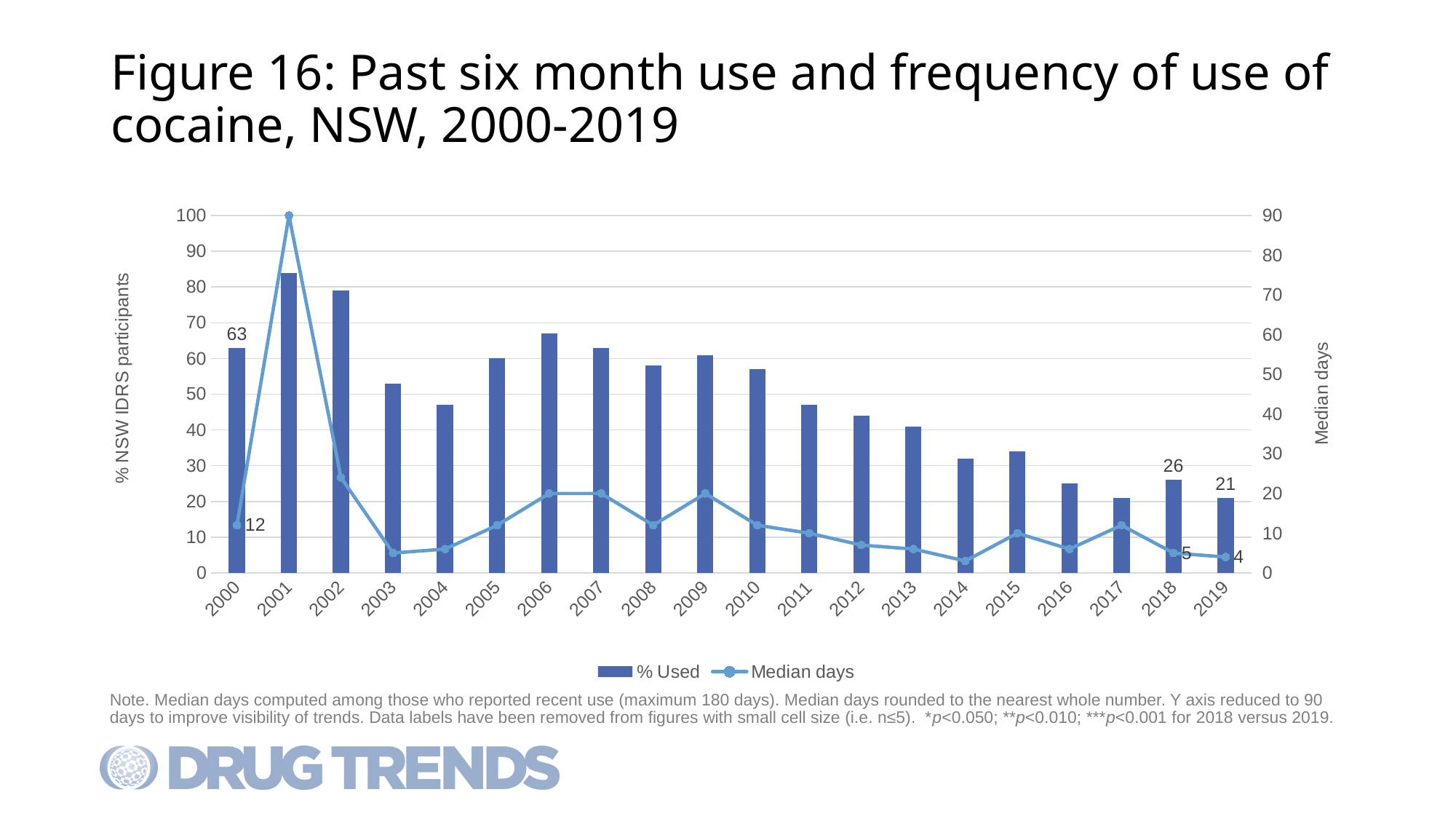
How many years are shown on the x axis? 20 By how much did the % Used value fall from 2018 to 2019? 5 Is the % Used value for 2006 greater or less than 60? greater How many series does the legend list? 2 What is the % Used value for 2000? 63 Which year has the highest Median days value? 2001 What is the difference between the Median days value in 2000 and in 2019? 8 What is the % Used value for 2018? 26 Is the % Used value for 2014 greater or less than 40? less What is the Median days value for 2000? 12 Which year has the highest % Used value? 2001 What is the Median days value for 2019? 4